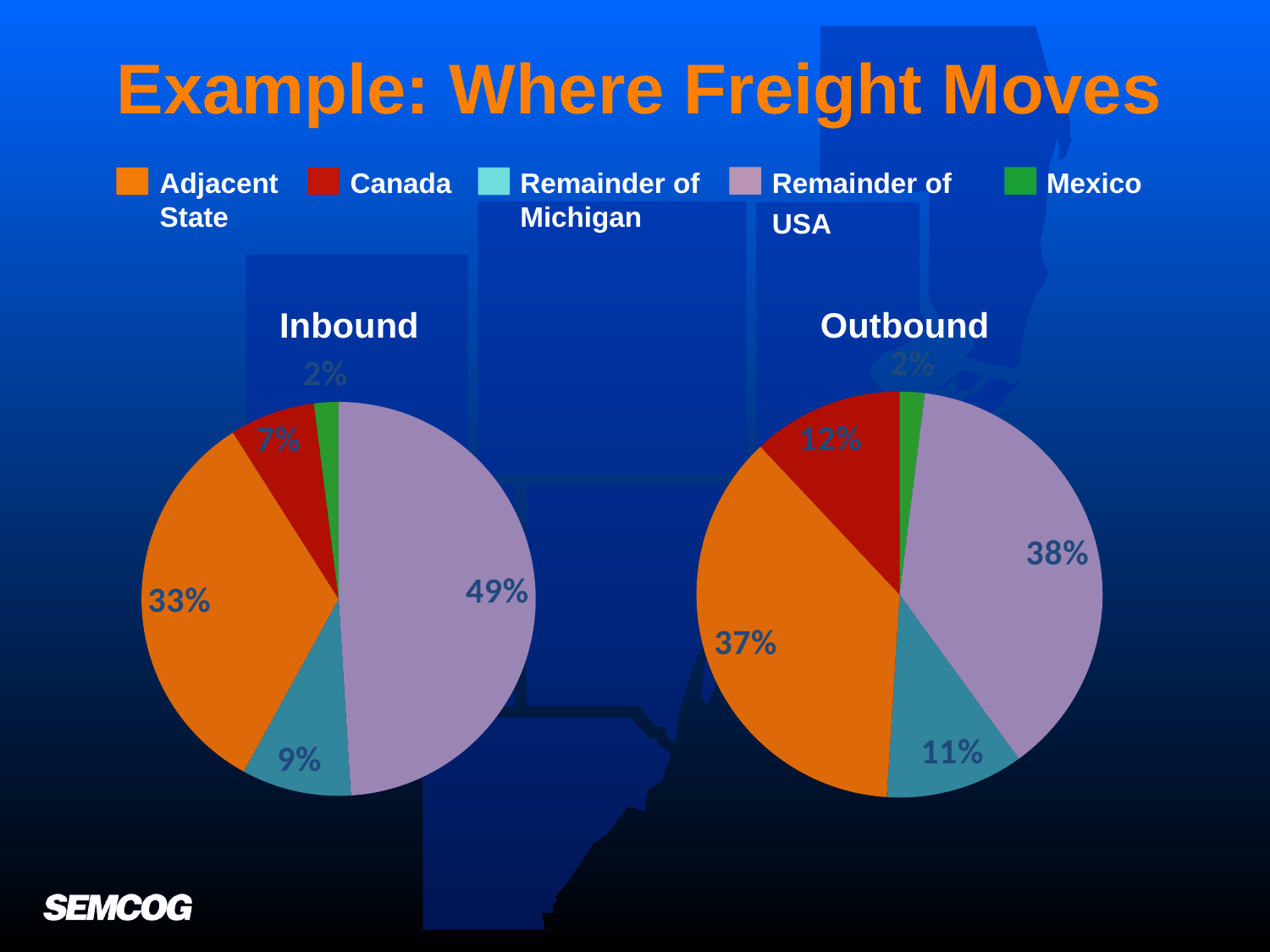
What kind of charts are shown on the slide? Pie charts In the Inbound pie chart, what share goes to Adjacent State? 33% In the Outbound pie chart, what share goes to Remainder of Michigan? 11% Which colour represents Mexico in the legend? Green In the Inbound pie chart, which category has the largest share? Remainder of USA Is the Canada share larger in the Inbound chart or the Outbound chart? Outbound In the Inbound pie chart, what is the difference between the Remainder of USA share and the Adjacent State share? 16% In the Outbound pie chart, which category has the smallest share? Mexico How many categories does the legend list? 5 What is the difference between the Adjacent State share in the Outbound chart and in the Inbound chart? 4% In the Outbound pie chart, what share goes to Canada? 12%